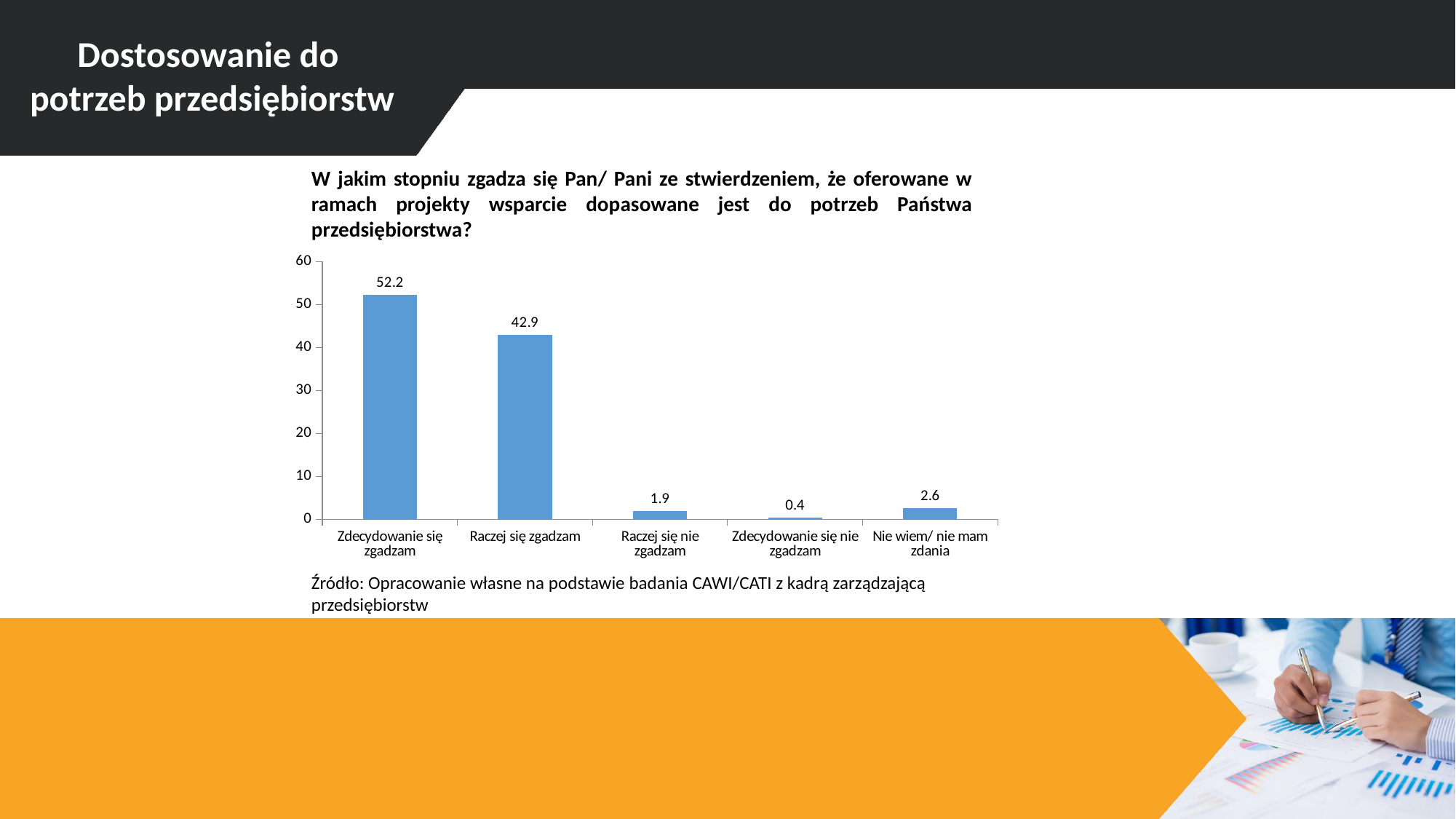
What kind of chart is shown on the slide? bar chart Is the value for "Raczej się zgadzam" greater or less than 40? greater What is the difference between the values for "Zdecydowanie się zgadzam" and "Raczej się zgadzam"? 9.3 What is the value for "Raczej się zgadzam"? 42.9 What is the value for "Zdecydowanie się zgadzam"? 52.2 Which is larger, the value for "Nie wiem/ nie mam zdania" or the value for "Raczej się nie zgadzam"? Nie wiem/ nie mam zdania Which category has the highest value? Zdecydowanie się zgadzam What is the value for "Raczej się nie zgadzam"? 1.9 What is the value for "Zdecydowanie się nie zgadzam"? 0.4 How many categories are shown on the x axis of the chart? 5 Which category has the lowest value? Zdecydowanie się nie zgadzam What is the value for "Nie wiem/ nie mam zdania"? 2.6